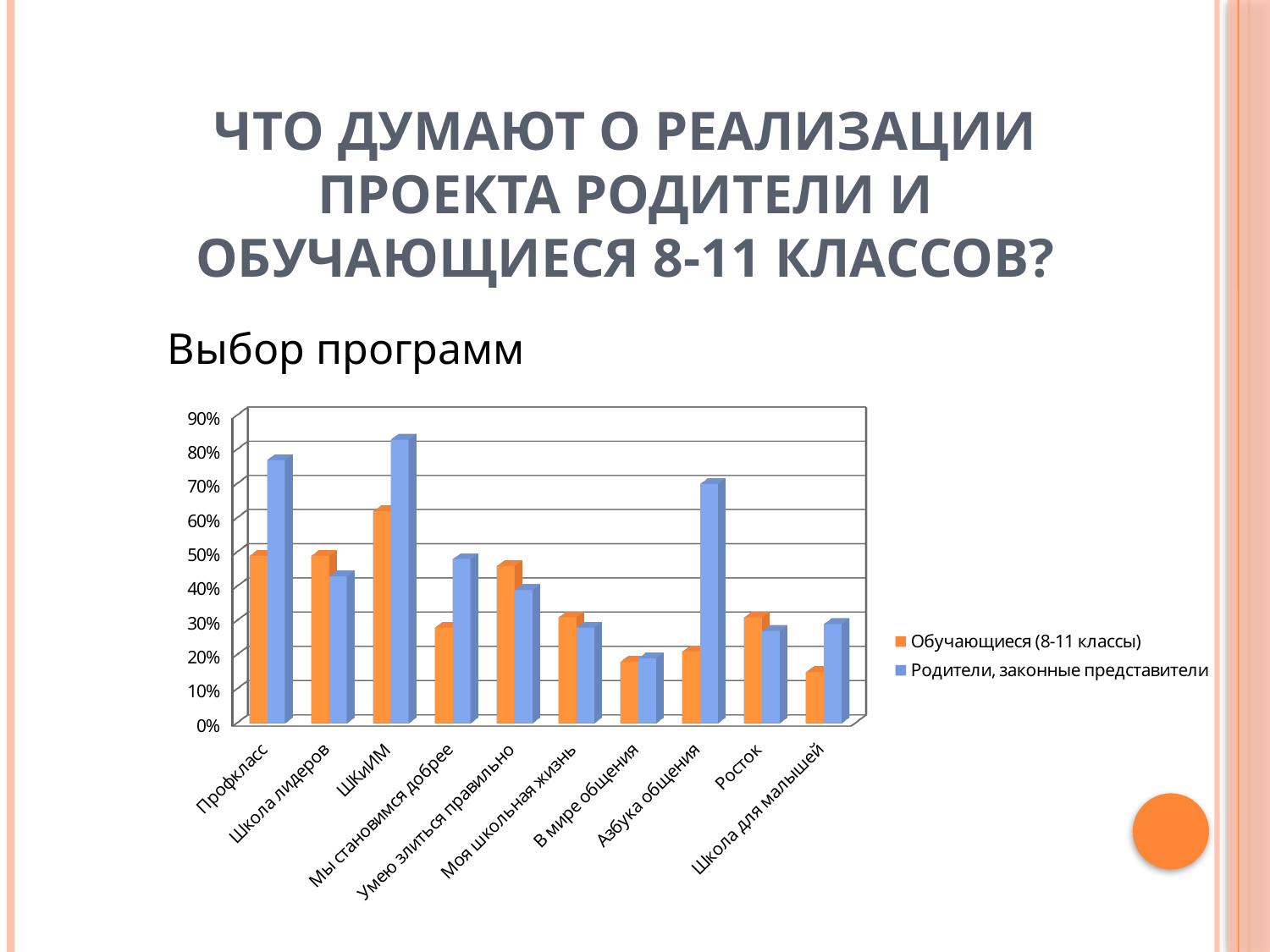
Is the value for Обучающиеся (8-11 классы) for Мы становимся добрее greater or less than 40%? less For Умею злиться правильно, which series has the larger value: Обучающиеся (8-11 классы) or Родители, законные представители? Обучающиеся (8-11 классы) For Азбука общения, which series has the larger value: Обучающиеся (8-11 классы) or Родители, законные представители? Родители, законные представители Which programme has the highest value for the series Обучающиеся (8-11 классы)? ШКиИМ Which programme has the lowest value for the series Обучающиеся (8-11 классы)? Школа для малышей Is the value for Родители, законные представители for Азбука общения greater or less than 60%? greater How many series does the chart legend list? 2 What is the title shown above the chart? Выбор программ Is the value for Родители, законные представители for Профкласс greater or less than 70%? greater What kind of chart is shown on the slide? bar chart How many programme categories are shown on the x axis of the chart? 10 Which programme has the highest value for the series Родители, законные представители? ШКиИМ